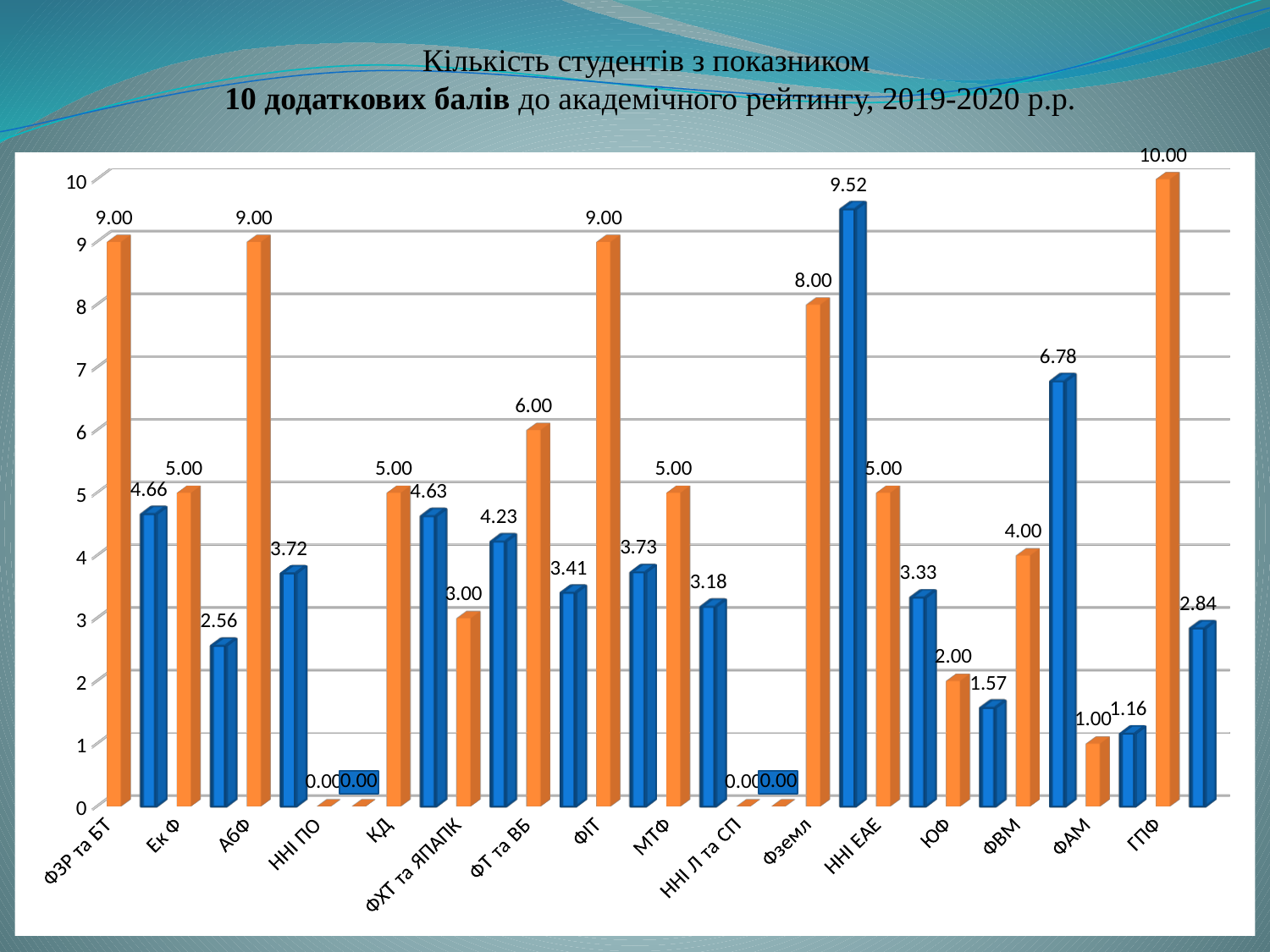
How many categories are shown on the x axis? 16 Which is larger for ФХТ та ЯПАПК, the orange bar or the blue bar? the blue bar What is the value of the blue bar for Фземл? 9.52 Which two categories have both bars equal to 0.00? ННІ ПО and ННІ Л та СП Which is larger for ФІТ, the orange bar or the blue bar? the orange bar What kind of chart is shown on the slide? bar chart What is the value of the blue bar for ФВМ? 6.78 What is the value of the orange bar for ГПФ? 10.00 Which category has the highest orange bar? ГПФ What is the value of the orange bar for ФТ та ВБ? 6.00 What is the difference between the orange and blue bars for ФЗР та БТ? 4.34 Which category has the highest blue bar? Фземл